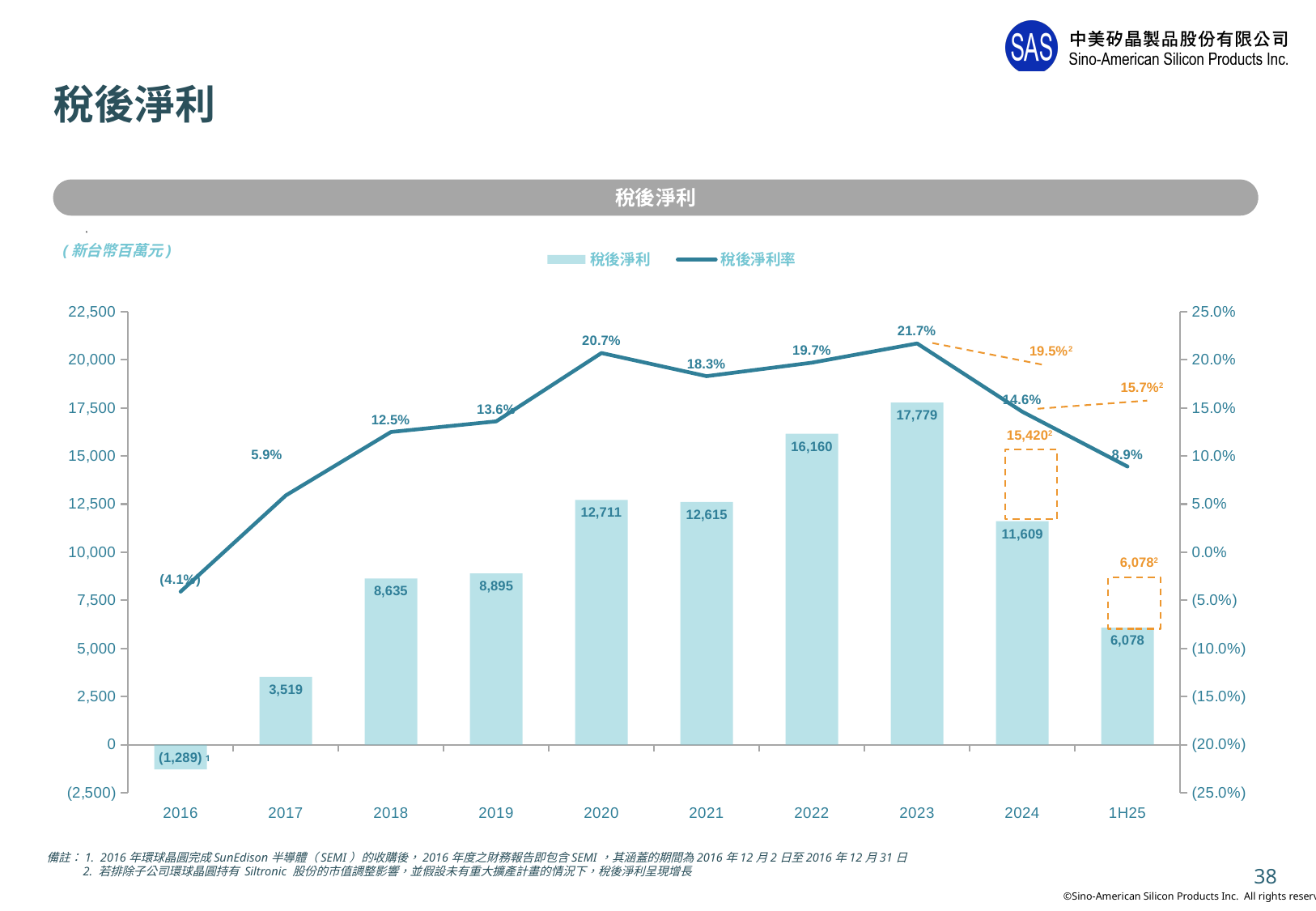
What kind of chart is used to show 稅後淨利? bar chart What is the 稅後淨利率 for 1H25 shown on the solid line? 8.9% How many periods are shown on the x axis? 10 Is the 稅後淨利 value for 2024 greater or less than 10,000? greater Which year has the lowest 稅後淨利率? 2016 Which is larger, the 稅後淨利 for 2020 or for 2021? 2020 What is the difference between the 稅後淨利 values for 2022 and 2021? 3,545 What is the 稅後淨利 value for 2016? (1,289) What is the 稅後淨利率 for 2020? 20.7% How many series does the legend list? 2 Which year has the highest 稅後淨利 bar? 2023 What is the 稅後淨利 value for 2023? 17,779